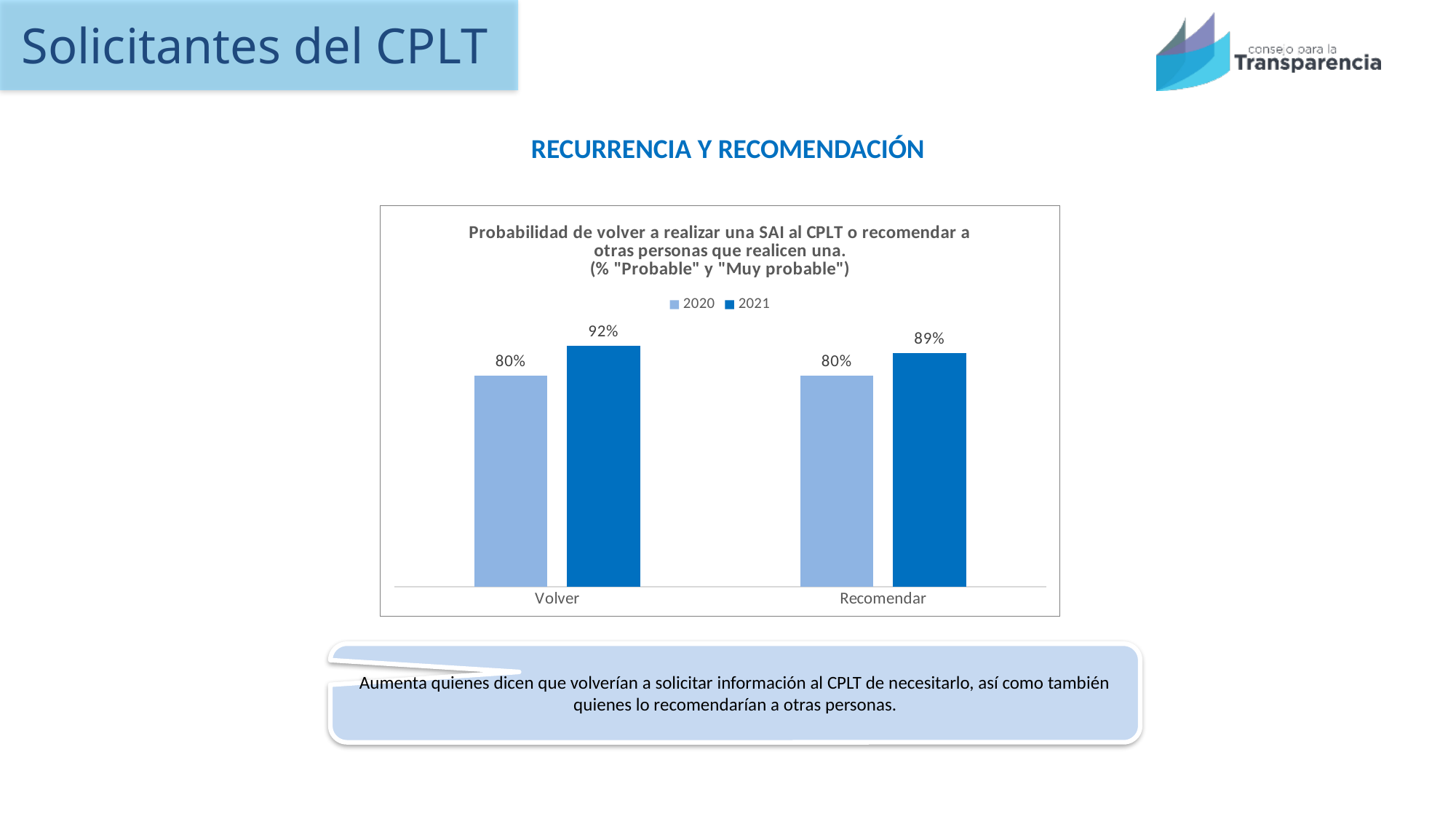
How many series does the legend list? 2 What is the value for Volver in 2021? 92% What is the difference between the 2021 and 2020 values for Recomendar? 9% Which series is shown in the darker blue colour? 2021 Which category has the highest value in 2021? Volver What is the difference between the 2021 and 2020 values for Volver? 12% Which is larger for Recomendar, the 2020 value or the 2021 value? 2021 How many categories are shown on the x axis? 2 What kind of chart is shown? Bar chart What is the value for Recomendar in 2021? 89% What is the value for Volver in 2020? 80% What is the value for Recomendar in 2020? 80%